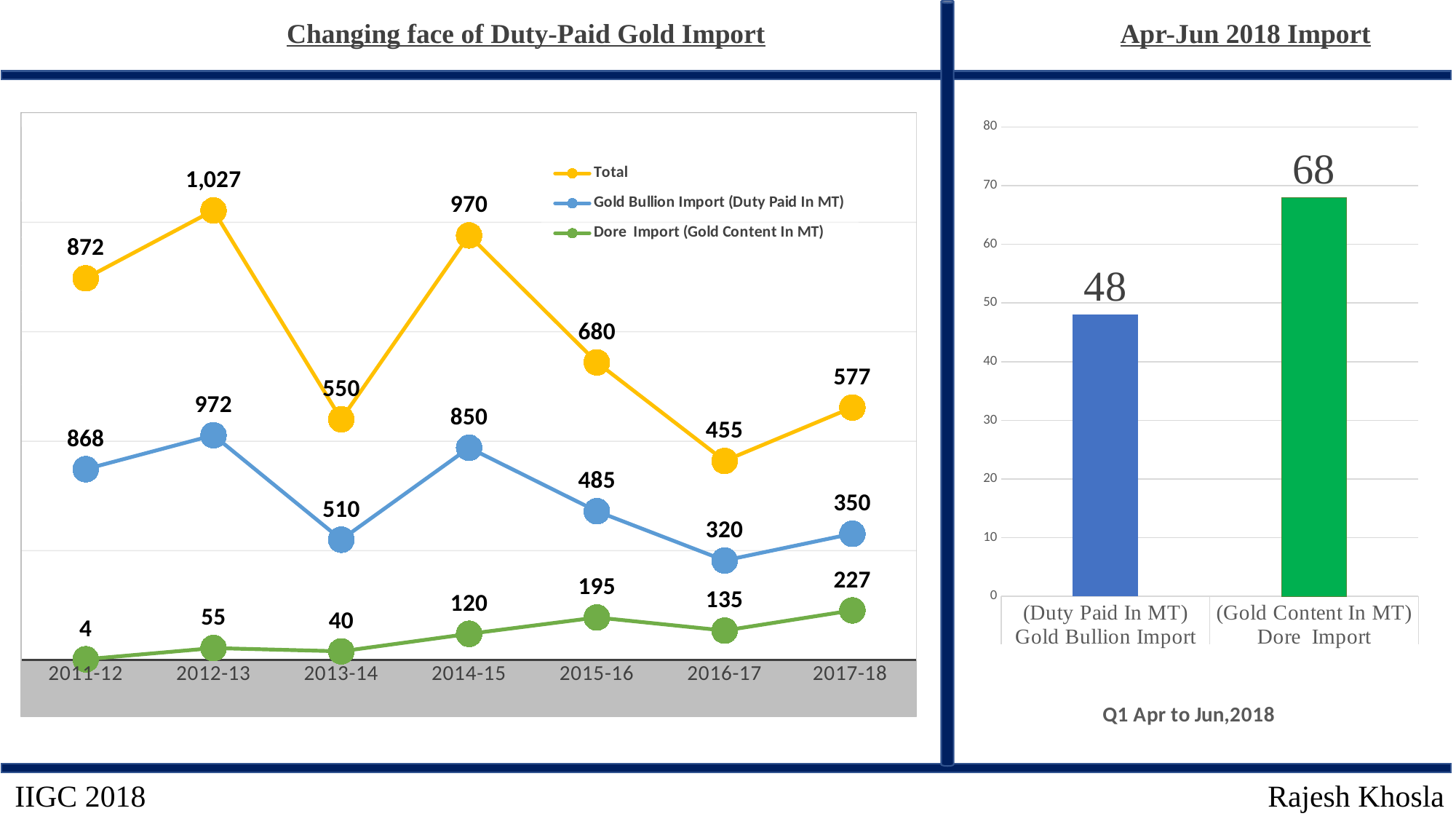
In the 'Changing face of Duty-Paid Gold Import' chart, what is the Gold Bullion Import (Duty Paid In MT) value for 2015-16? 485 In the 'Changing face of Duty-Paid Gold Import' chart, what is the Total value for 2012-13? 1,027 In the 'Changing face of Duty-Paid Gold Import' chart, which year has the lowest Total value? 2016-17 In the 'Changing face of Duty-Paid Gold Import' chart, what is the Dore Import (Gold Content In MT) value for 2017-18? 227 In the 'Apr-Jun 2018 Import' chart, what is the difference between the Dore Import and Gold Bullion Import values? 20 In the 'Changing face of Duty-Paid Gold Import' chart, how many series does the legend list? 3 In the 'Changing face of Duty-Paid Gold Import' chart, how many years are shown on the x axis? 7 What kind of chart is the 'Apr-Jun 2018 Import' chart? bar chart In the 'Changing face of Duty-Paid Gold Import' chart, which year has the highest Dore Import (Gold Content In MT) value? 2017-18 In the 'Apr-Jun 2018 Import' chart, what is the value for Dore Import (Gold Content In MT)? 68 In the 'Changing face of Duty-Paid Gold Import' chart, what is the difference between the Total values for 2014-15 and 2013-14? 420 In the 'Changing face of Duty-Paid Gold Import' chart, does the Dore Import (Gold Content In MT) series generally rise or fall from 2011-12 to 2017-18? rise